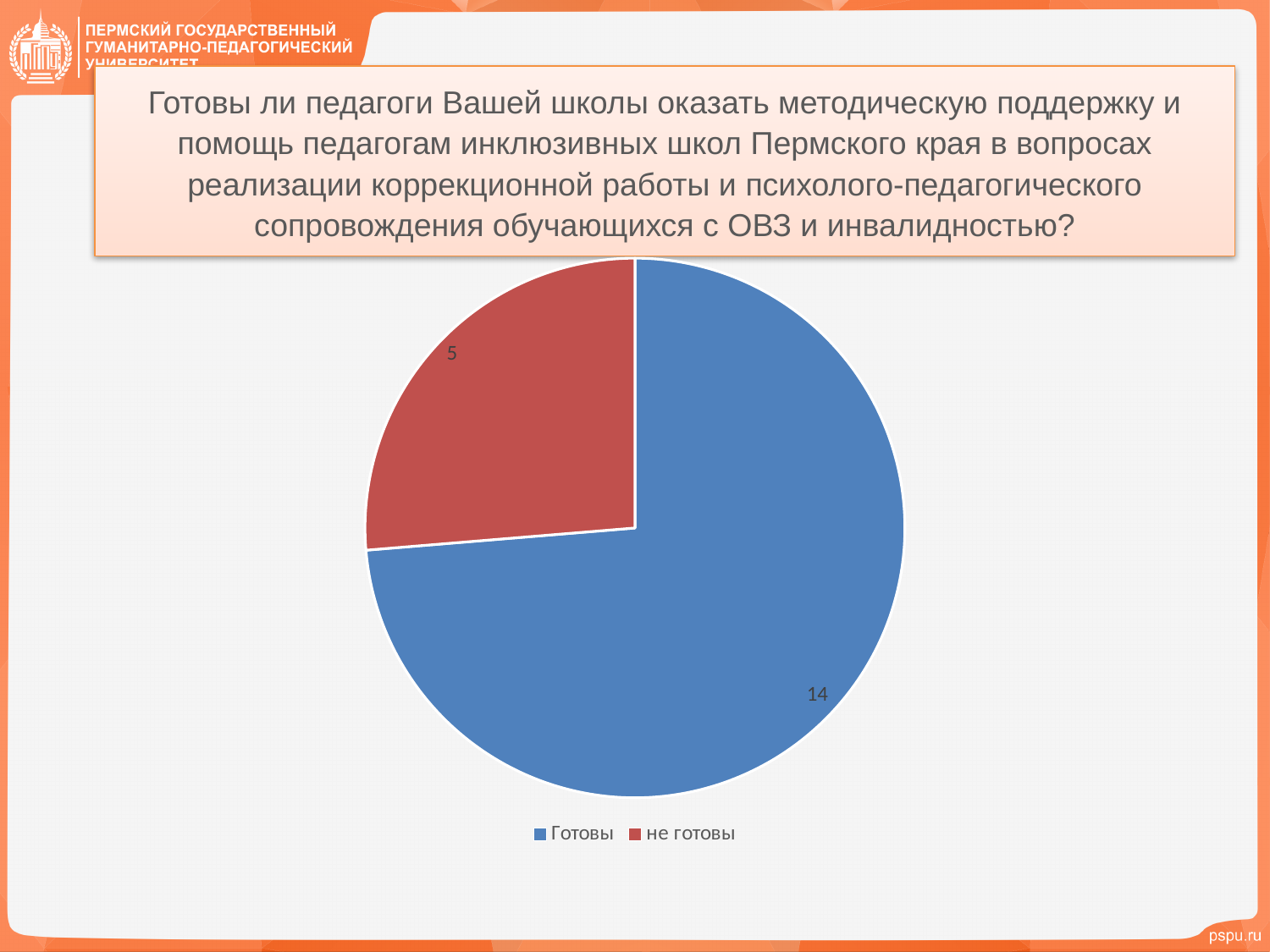
What is the total of all slices in the pie chart? 19 Which is larger, the value for "Готовы" or for "не готовы"? Готовы Which category has the largest slice of the pie? Готовы What kind of chart is shown on the slide? pie chart What is the value for the "не готовы" slice? 5 What colour is the "Готовы" slice? blue What is the difference between the "Готовы" and "не готовы" values? 9 What fraction of the total does the "не готовы" slice represent? 5 out of 19 How many slices does the pie chart have? 2 What is the value for the "Готовы" slice? 14 How many entries does the legend list? 2 Which category has the smallest slice of the pie? не готовы